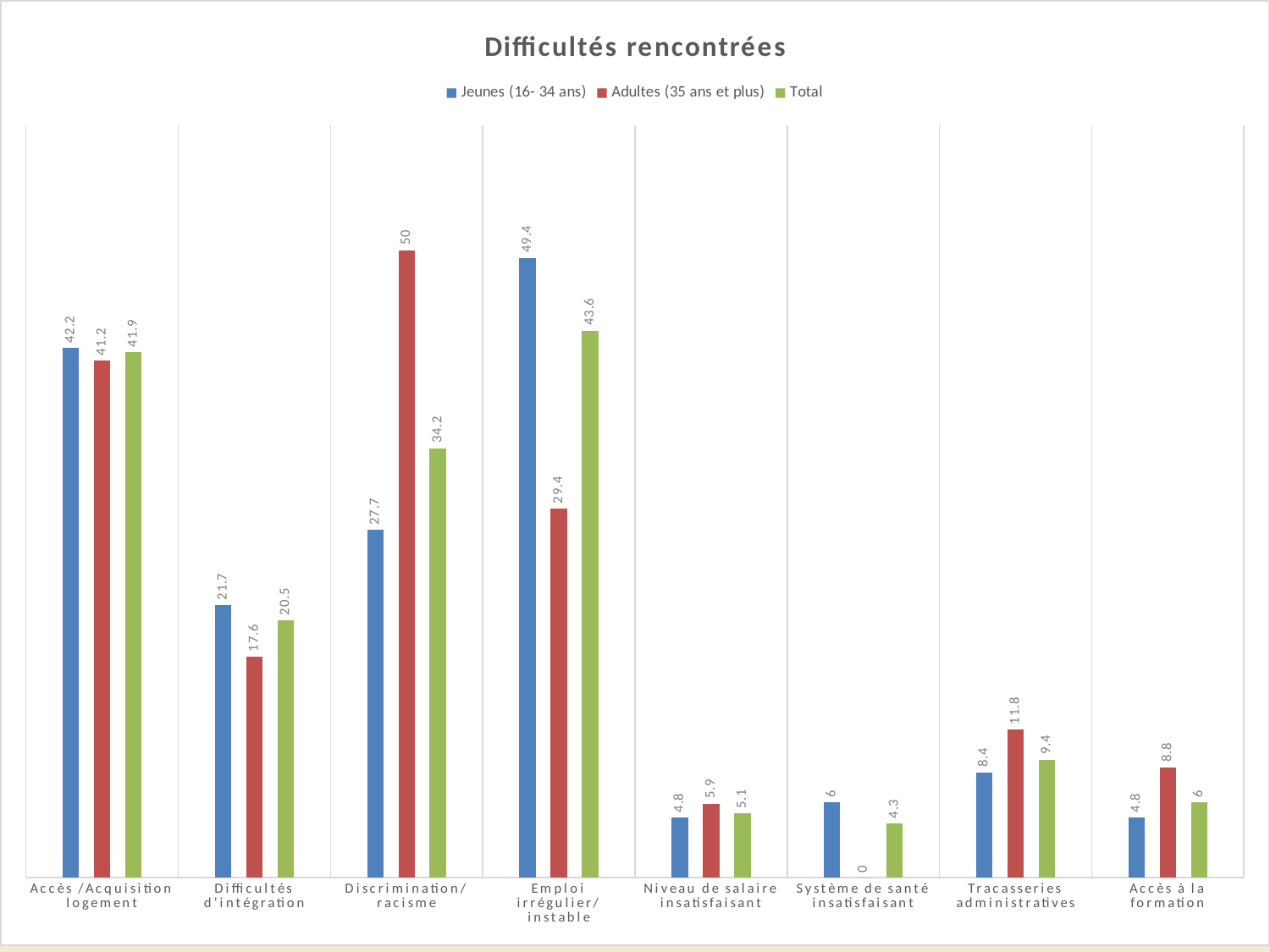
What is the value for Adultes (35 ans et plus) in the Système de santé insatisfaisant category? 0 What kind of chart is this? Bar chart What is the title of the chart? Difficultés rencontrées What is the value for Adultes (35 ans et plus) in the Discrimination/racisme category? 50 Which category has the lowest value for Jeunes (16- 34 ans)? Niveau de salaire insatisfaisant and Accès à la formation (both 4.8) What is the Total value for Accès /Acquisition logement? 41.9 How many categories are shown on the x axis? 8 Which is larger for Tracasseries administratives: the Jeunes (16- 34 ans) value or the Adultes (35 ans et plus) value? Adultes (35 ans et plus) What is the difference between the Adultes (35 ans et plus) and Jeunes (16- 34 ans) values for Discrimination/racisme? 22.3 How many series does the legend list? 3 Which category has the highest Total value? Emploi irrégulier/instable What is the value for Jeunes (16- 34 ans) in the Emploi irrégulier/instable category? 49.4